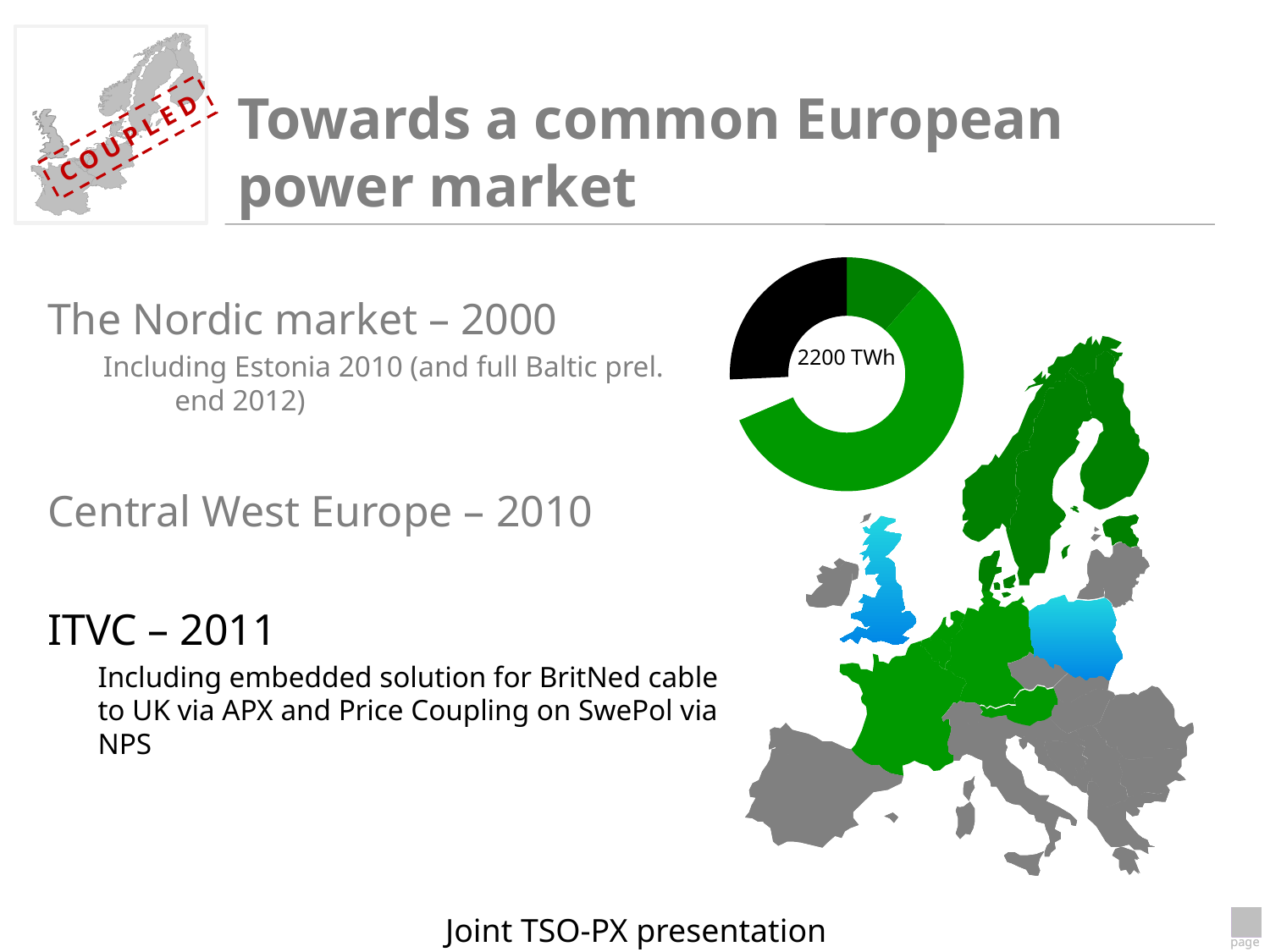
What text is printed in the centre of the doughnut chart? 2200 TWh Does the doughnut chart have a legend? No In the doughnut chart, is the bright green slice or the black slice larger? Bright green What kind of chart is shown on the slide? Doughnut chart Which colour slice is the largest in the doughnut chart? Bright green In the doughnut chart, is the black slice or the dark green slice larger? Black How many slices does the doughnut chart have? 4